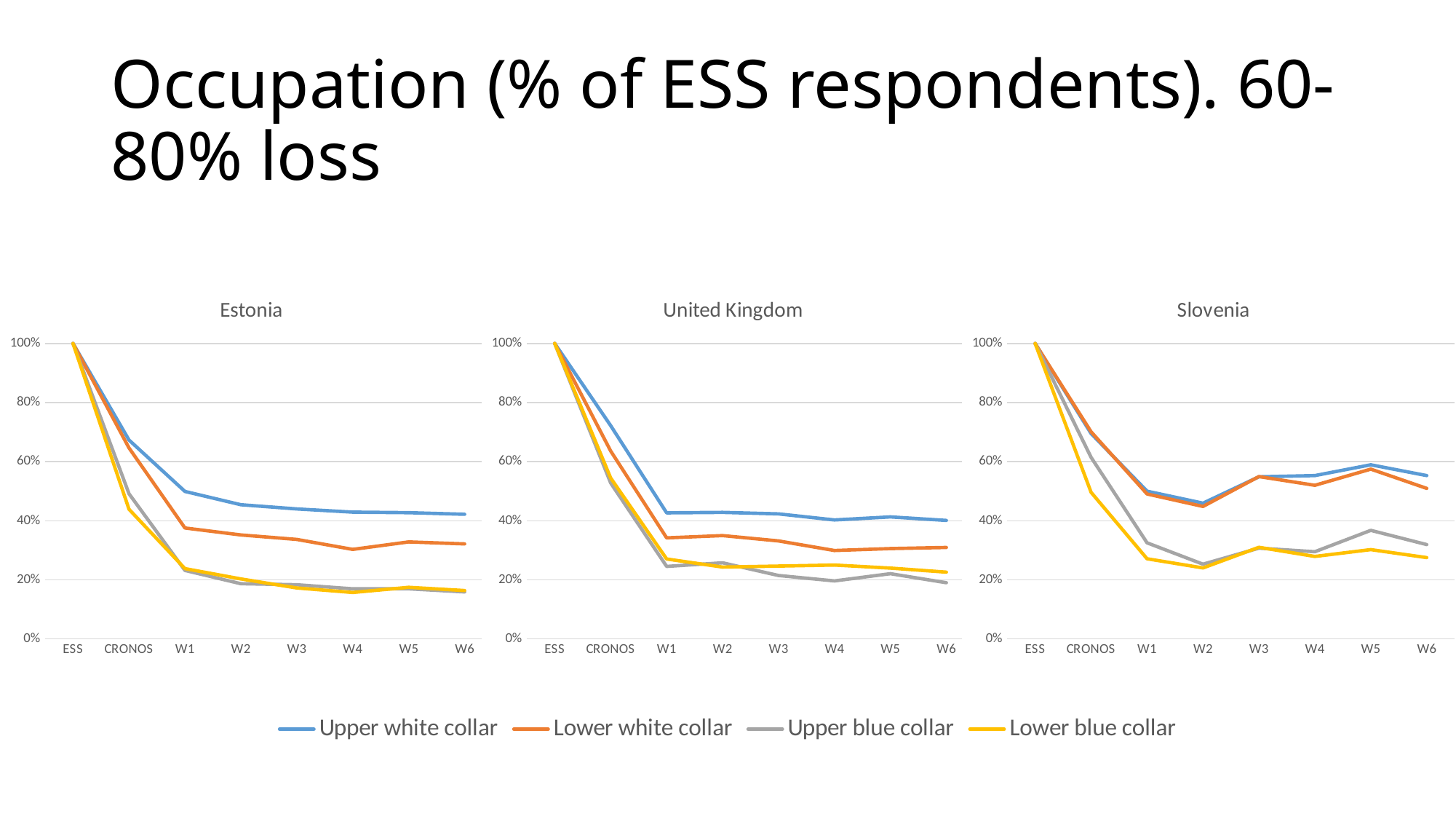
What is the title of the middle chart? United Kingdom In the United Kingdom chart, how many points are there along the x axis? 8 In the Slovenia chart, which series has the highest value at W6? Upper white collar In the Estonia chart, what is the value for Upper white collar at ESS? 100% How many series does the legend list? 4 In the Estonia chart, is the value for Lower blue collar at W6 greater or less than 20%? less In the Slovenia chart, which series has the lowest value at W5? Lower blue collar In the United Kingdom chart, which is larger at W1: Upper white collar or Lower white collar? Upper white collar In the Estonia chart, does the Upper white collar line rise or fall from ESS to W6? Fall In the Slovenia chart, is the value for Lower blue collar at W2 greater or less than 40%? less In the United Kingdom chart, is the value for Upper white collar at CRONOS greater or less than 60%? greater What kind of chart is the Estonia chart? Line chart